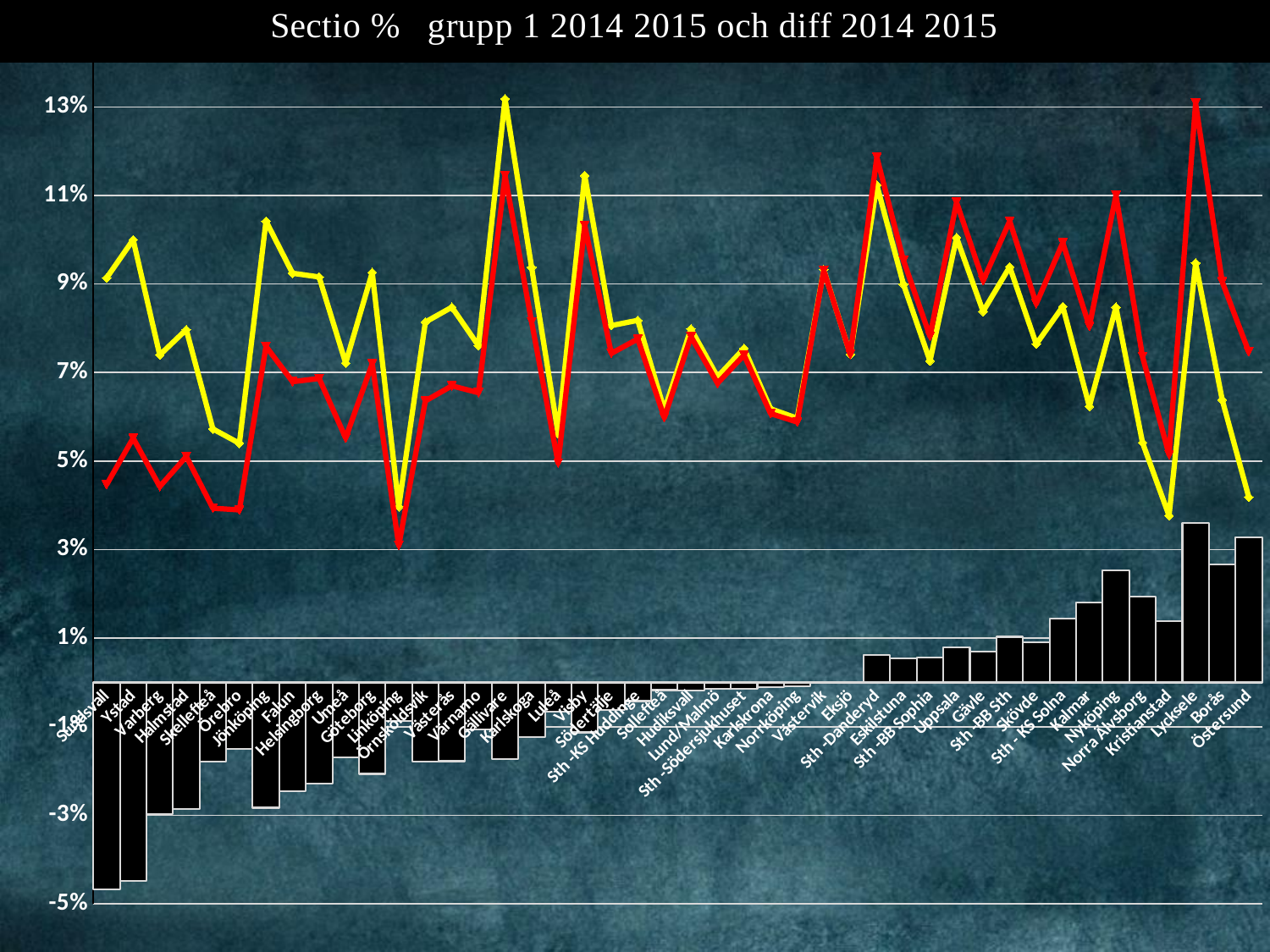
At which category does the yellow line reach its highest point? Gällivare Is the bar value for Sundsvall greater or less than -3%? less Is the yellow line value for Linköping greater or less than 5%? less What kind of chart is shown on the slide? A combination of line and bar chart What is the title of the chart? Sectio % grupp 1 2014 2015 och diff 2014 2015 At Sundsvall, which line has the higher value, the yellow line or the red line? The yellow line Is the red line value for Lycksele greater or less than 11%? greater Do the bar values generally rise or fall from left to right along the x axis? Rise At which category does the red line reach its highest point? Lycksele Which category has the highest bar on the chart? Lycksele What colours are the two lines plotted on the chart? Yellow and red